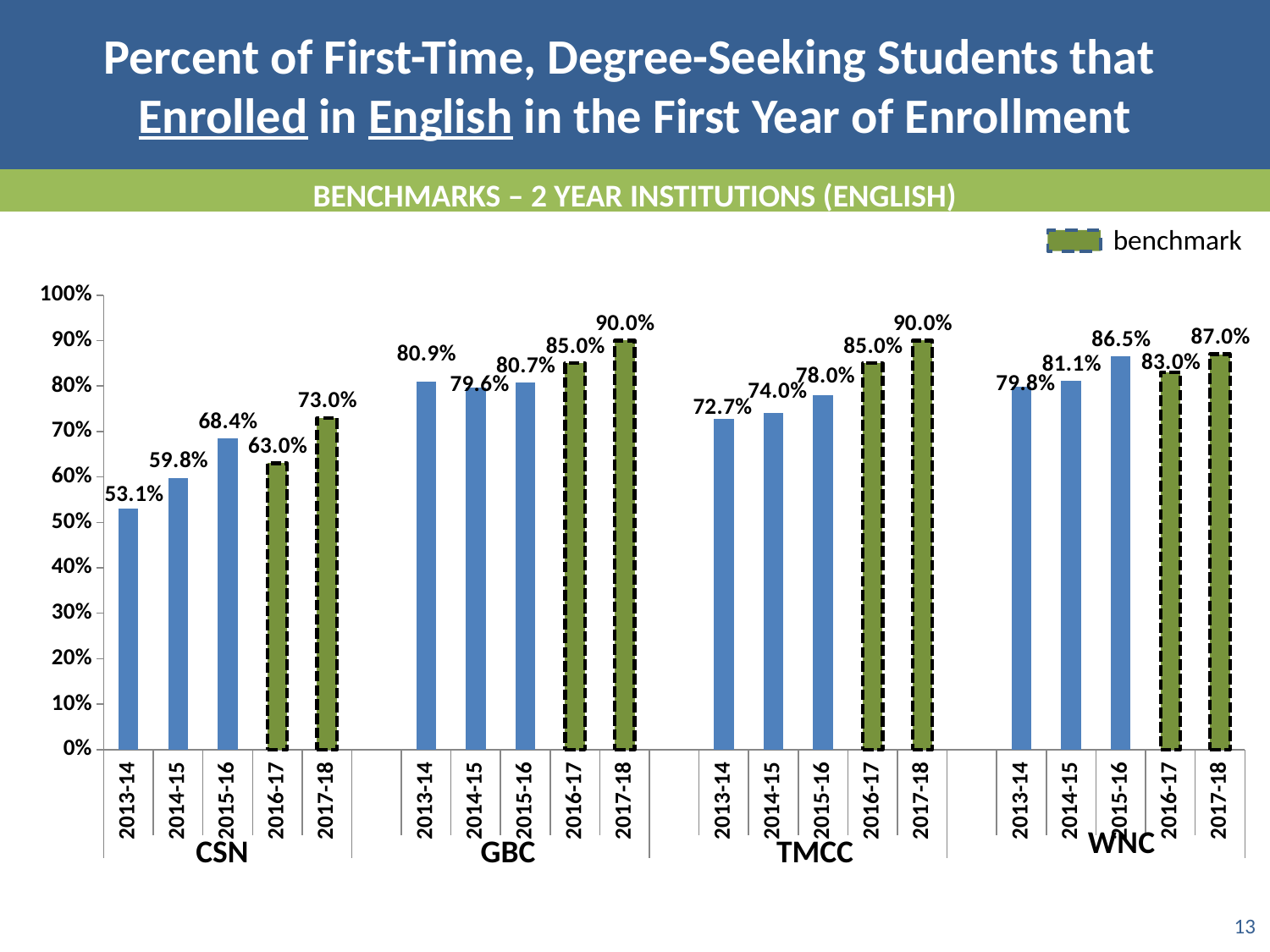
What is the 2017-18 benchmark value for WNC? 87.0% Is the value for CSN in 2014-15 greater or less than 60%? less Which institution has the lowest value in 2013-14? CSN What is the value for CSN in 2013-14? 53.1% What is the difference between the CSN values for 2015-16 and 2013-14? 15.3% Which institution has the highest value in 2015-16? WNC What does the legend entry with the green dashed bar represent? benchmark How many institutions are shown on the x axis? 4 Do the CSN values rise or fall from 2013-14 to 2015-16? rise What is the value for TMCC in 2015-16? 78.0% Which is larger, the GBC value for 2013-14 or the WNC value for 2013-14? GBC 2013-14 What kind of chart is shown on the slide? bar chart